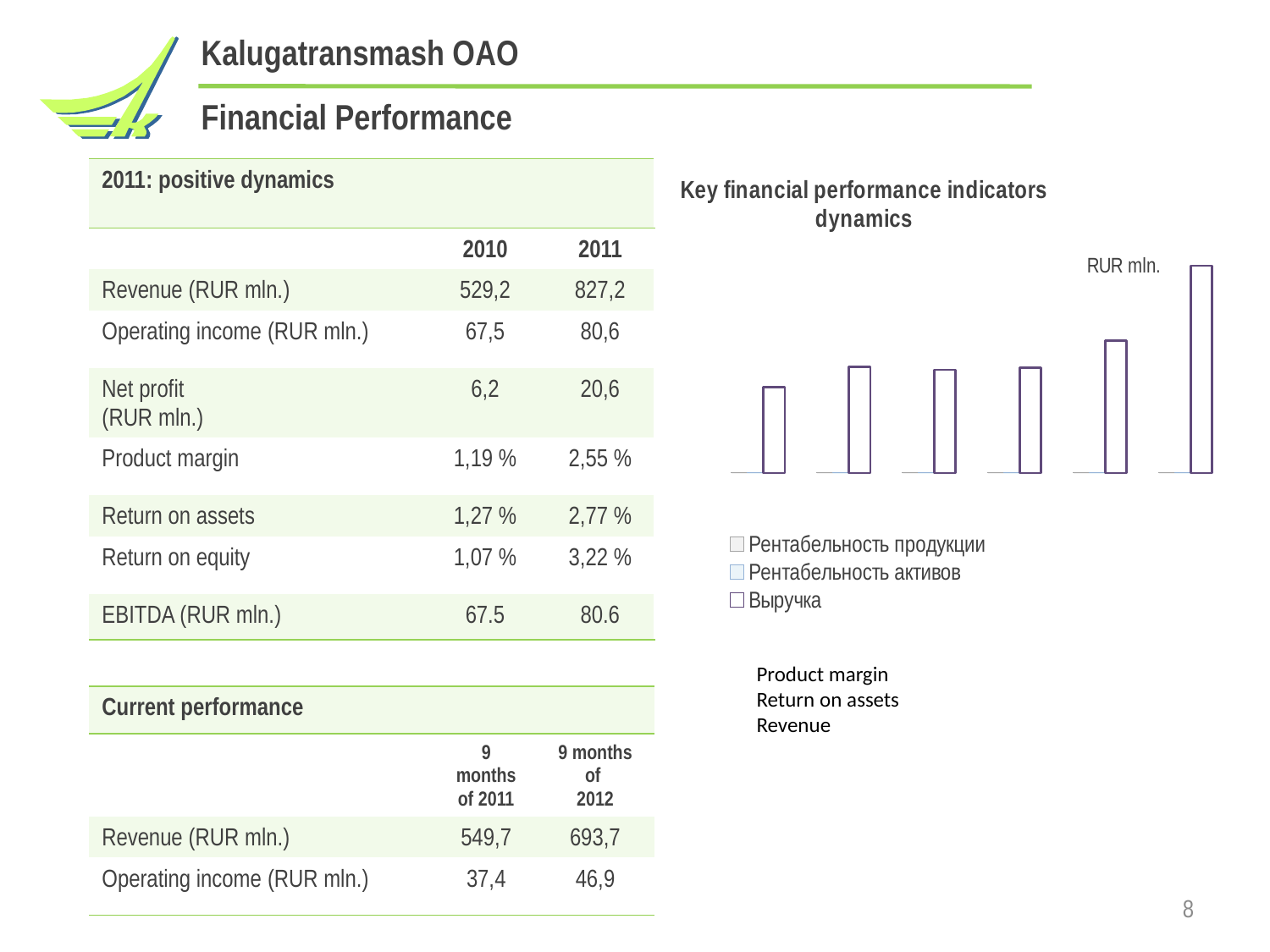
Do the bars in the "Key financial performance indicators dynamics" chart generally get taller or shorter from left to right? taller In the "Key financial performance indicators dynamics" chart, which bar is the shortest? the leftmost (first) bar In the "Key financial performance indicators dynamics" chart, which bar is the tallest? the rightmost (sixth) bar How many bars are plotted in the "Key financial performance indicators dynamics" chart? 6 What unit label is shown at the top of the "Key financial performance indicators dynamics" chart? RUR mln. How many entries does the legend of the "Key financial performance indicators dynamics" chart list? 3 In the "Key financial performance indicators dynamics" chart, is the first bar or the last bar taller? the last bar What kind of chart is shown under the title "Key financial performance indicators dynamics"? bar chart In the "Key financial performance indicators dynamics" chart, is the second bar or the fifth bar taller? the fifth bar What is the English name of the third legend entry (Выручка) in the "Key financial performance indicators dynamics" chart? Revenue In the "Key financial performance indicators dynamics" chart, is the first bar or the second bar taller? the second bar